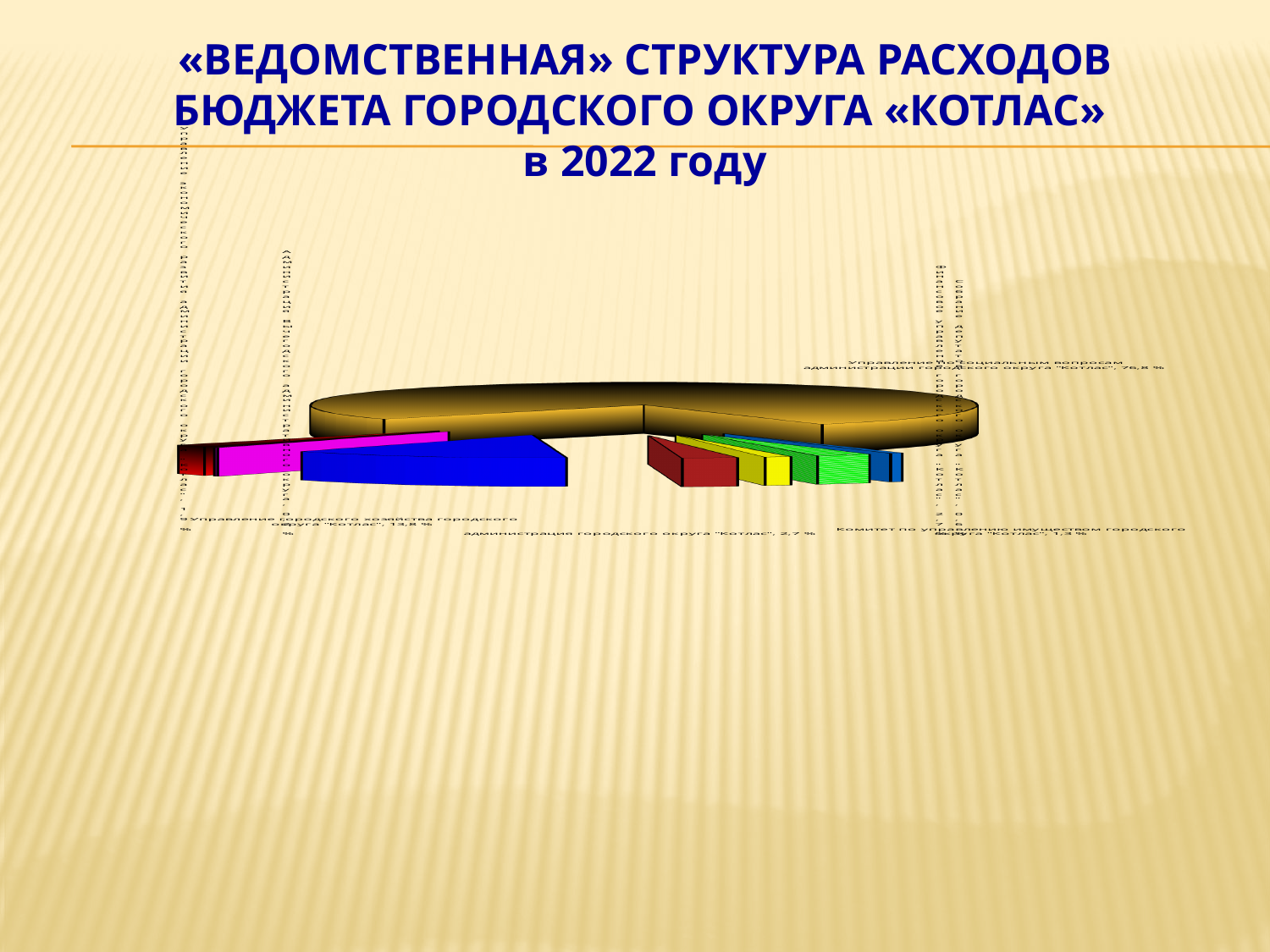
What share of expenditures is attributed to Комитет по управлению имуществом городского округа "Котлас"? 1,3 % By how many percentage points does the share of администрация городского округа "Котлас" exceed the share of Комитет по управлению имуществом? 1,4 % What share of expenditures is attributed to администрация городского округа "Котлас"? 2,7 % What share of expenditures is attributed to Управление по социальным вопросам администрации городского округа "Котлас"? 76,8 % By how many percentage points does the share of Управление по социальным вопросам exceed the share of Управление городского хозяйства? 63,0 % Which department has the largest share of the budget expenditures? Управление по социальным вопросам администрации городского округа "Котлас" Which year does the chart's title refer to? 2022 What kind of chart is shown on the slide? pie chart What colour is the largest slice of the pie chart? gold Which is larger: the share of Управление городского хозяйства or the share of администрация городского округа "Котлас"? Управление городского хозяйства What share of expenditures is attributed to Управление городского хозяйства городского округа "Котлас"? 13,8 %